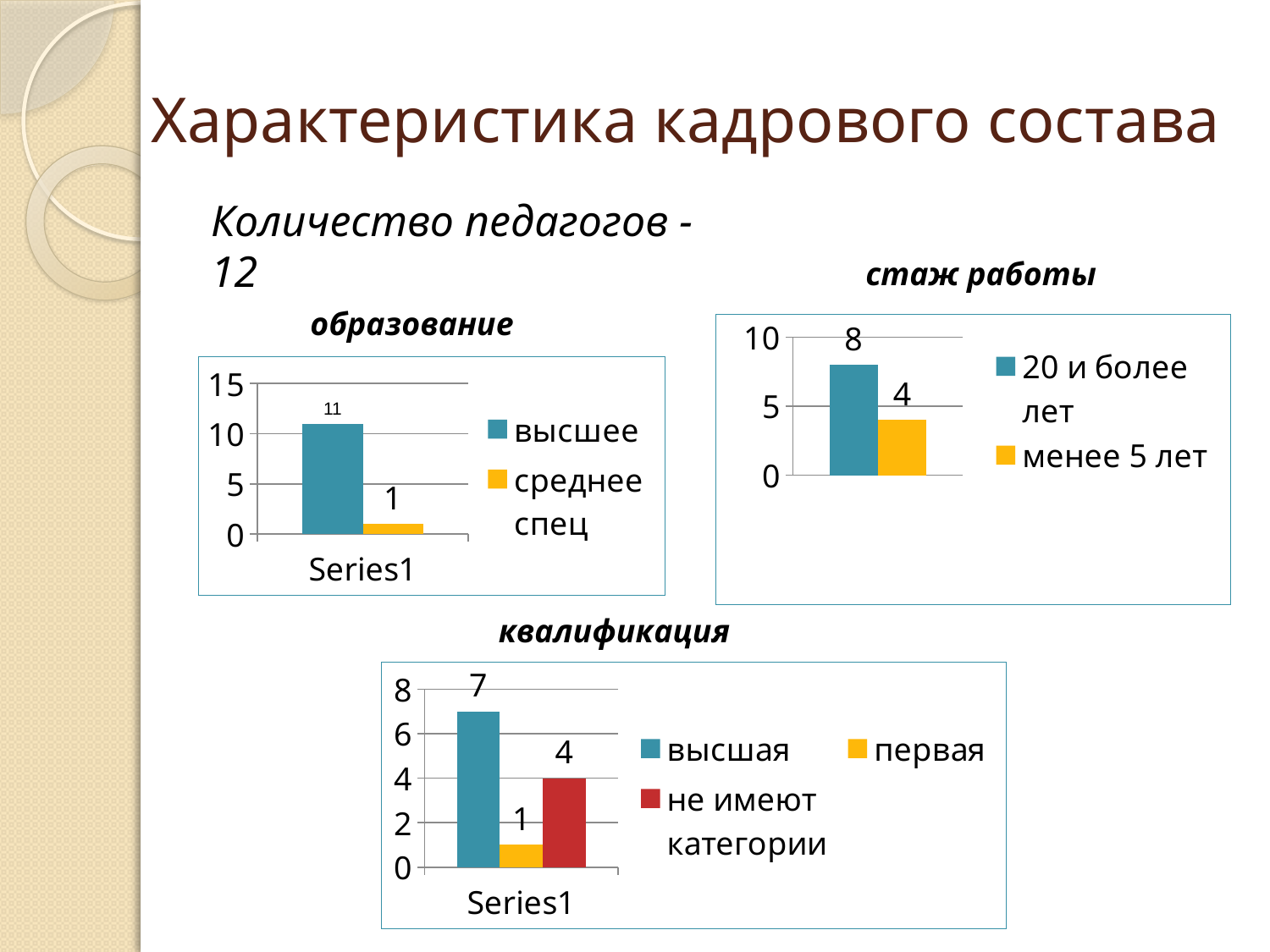
In the 'квалификация' chart, what is the difference between 'высшая' and 'не имеют категории'? 3 In the 'стаж работы' chart, which series is larger, '20 и более лет' or 'менее 5 лет'? 20 и более лет What kind of chart is the 'стаж работы' chart? bar chart In the 'стаж работы' chart, what is the value for '20 и более лет'? 8 In the 'образование' chart, what is the value for 'высшее'? 11 In the 'образование' chart, what is the value for 'среднее спец'? 1 In the 'стаж работы' chart, what is the value for 'менее 5 лет'? 4 In the 'квалификация' chart, what is the value for 'высшая'? 7 In the 'образование' chart, what is the difference between 'высшее' and 'среднее спец'? 10 In the 'квалификация' chart, what is the value for 'не имеют категории'? 4 In the 'квалификация' chart, how many series does the legend list? 3 In the 'квалификация' chart, which series has the lowest value? первая